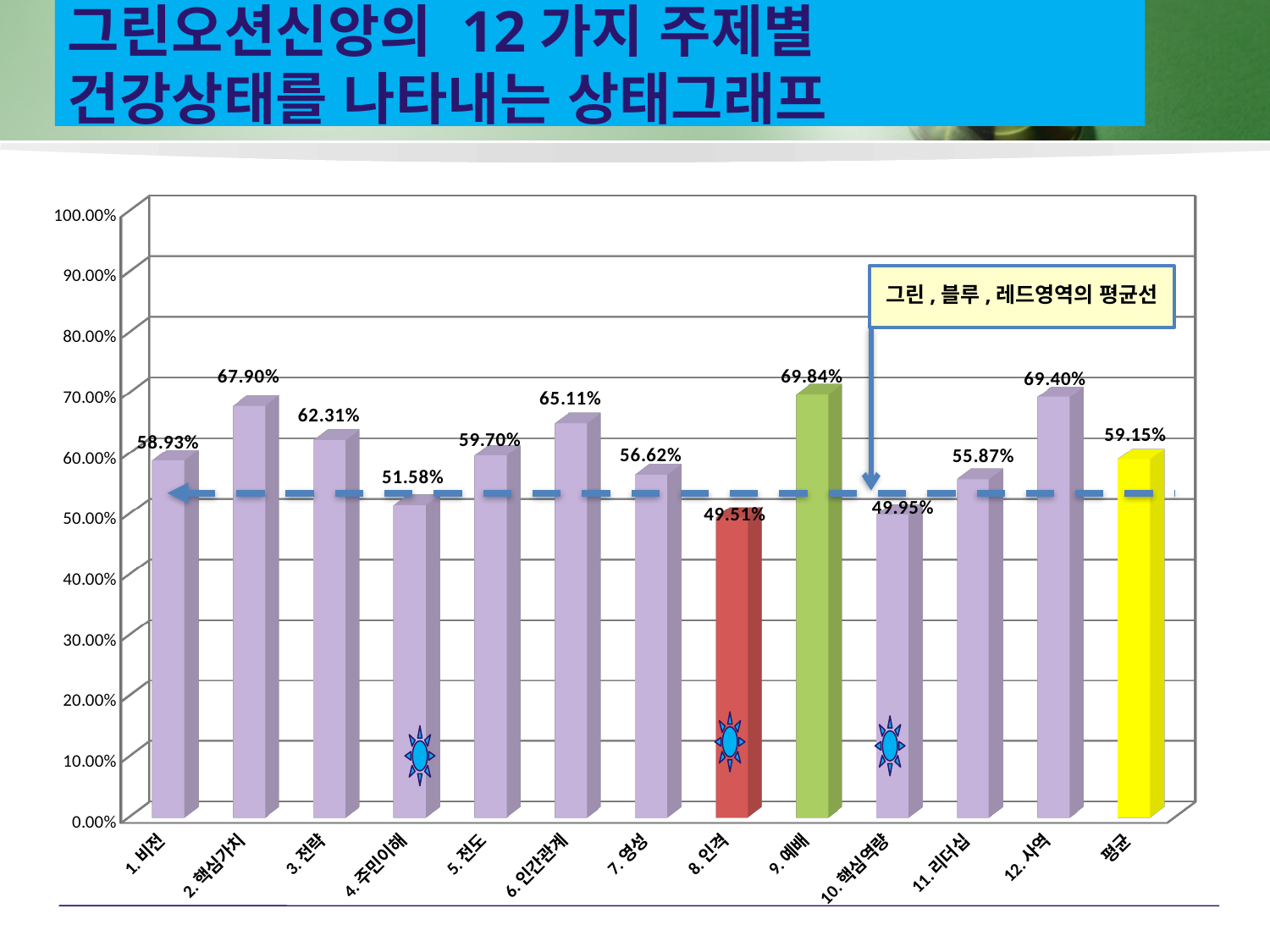
What is the value for 9. 예배? 69.84% How many bars are plotted in the chart? 13 What kind of chart is shown on the slide? bar chart Which category has the lowest value? 8. 인격 What does the text box above the dashed line say? 그린 , 블루 , 레드영역의 평균선 What is the value shown for the 평균 bar? 59.15% What colour is the bar for 8. 인격? red What is the difference between the values for 2. 핵심가치 and 1. 비전? 8.97% What is the value for 1. 비전? 58.93% Which category has the highest value? 9. 예배 Which is larger, the value for 3. 전략 or the value for 5. 전도? 3. 전략 Is the value for 4. 주민이해 greater or less than 60.00%? less